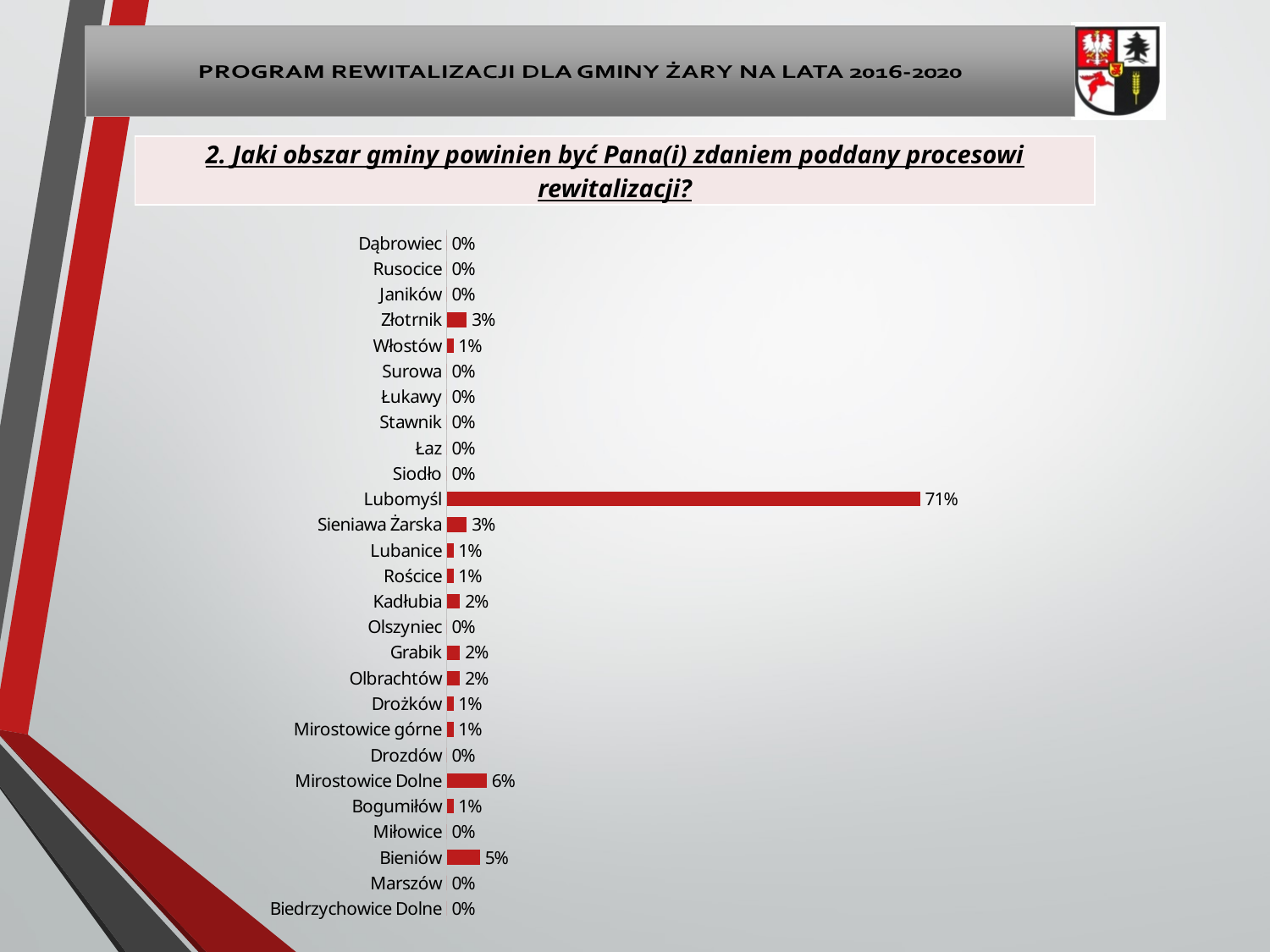
What is the value shown for Mirostowice Dolne? 6% Which has a larger value, Bieniów or Sieniawa Żarska? Bieniów Which area has the highest value in the chart? Lubomyśl What is the difference between the values for Mirostowice Dolne and Bieniów? 1% What colour are the bars in the chart? Red What is the value shown for Bieniów? 5% What percentage of respondents chose Lubomyśl? 71% Which has a larger value, Złotrnik or Włostów? Złotrnik What is the difference between the values for Lubomyśl and Mirostowice Dolne? 65% What is the value shown for Kadłubia? 2% How many areas (categories) are listed in the chart? 27 What type of chart is shown on the slide? Bar chart